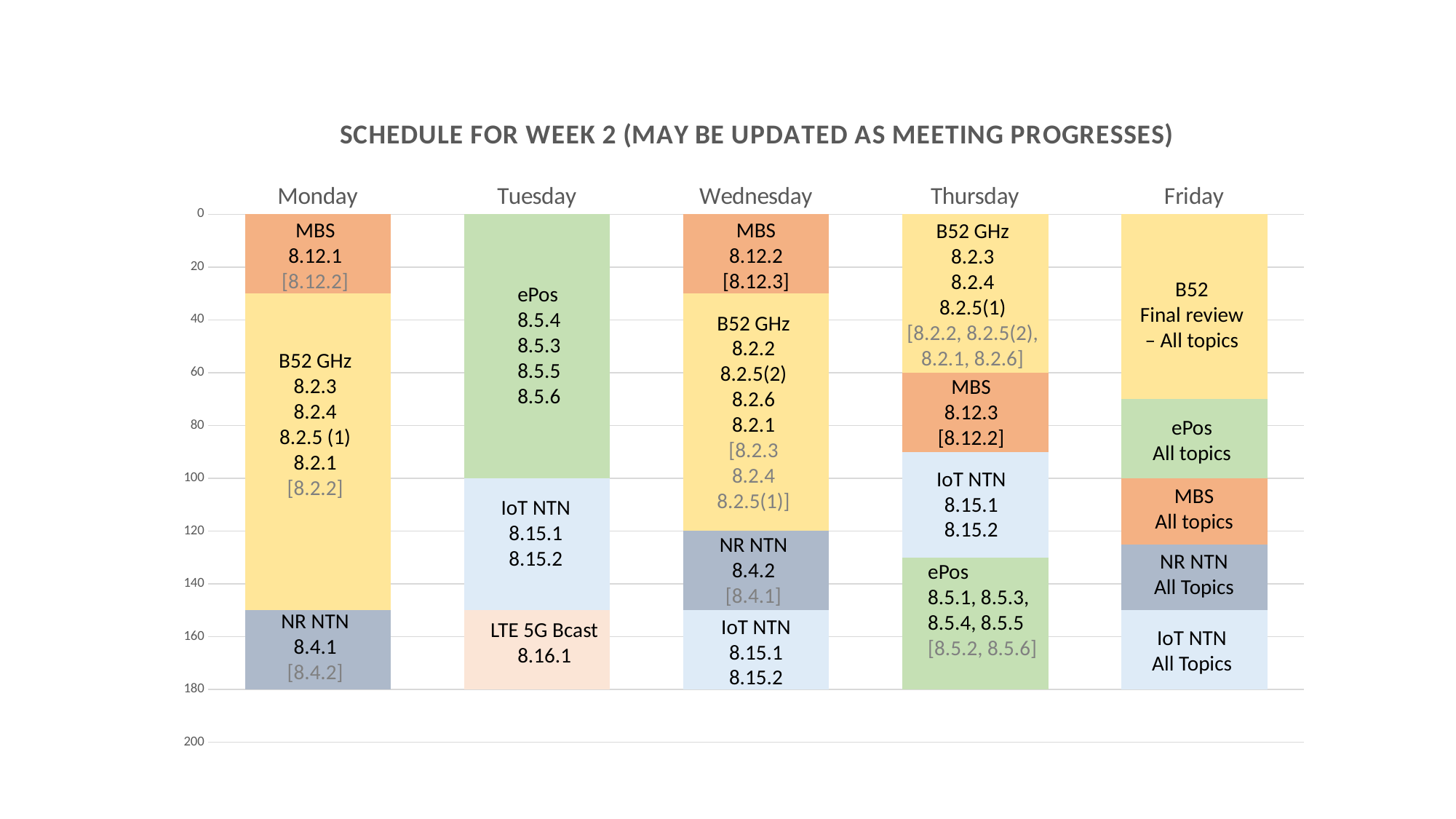
How many blocks make up the Friday bar? 5 How many days (bars) are shown on the chart? 5 How many blocks make up the Monday bar? 3 Which day has the most blocks in its bar? Friday What kind of chart is shown on the slide? stacked bar chart Is the end of the ePos block on Tuesday greater or less than 80 on the axis? greater Is the end of the B52 GHz block on Thursday greater or less than 40 on the axis? greater What is the title of the chart? SCHEDULE FOR WEEK 2 (MAY BE UPDATED AS MEETING PROGRESSES) Which topic is the last block on Tuesday? LTE 5G Bcast Which topic is the first block on Tuesday? ePos At what axis value do all five bars end? 180 Which day has the fewest blocks in its bar? Monday and Tuesday (tied with 3 blocks each)